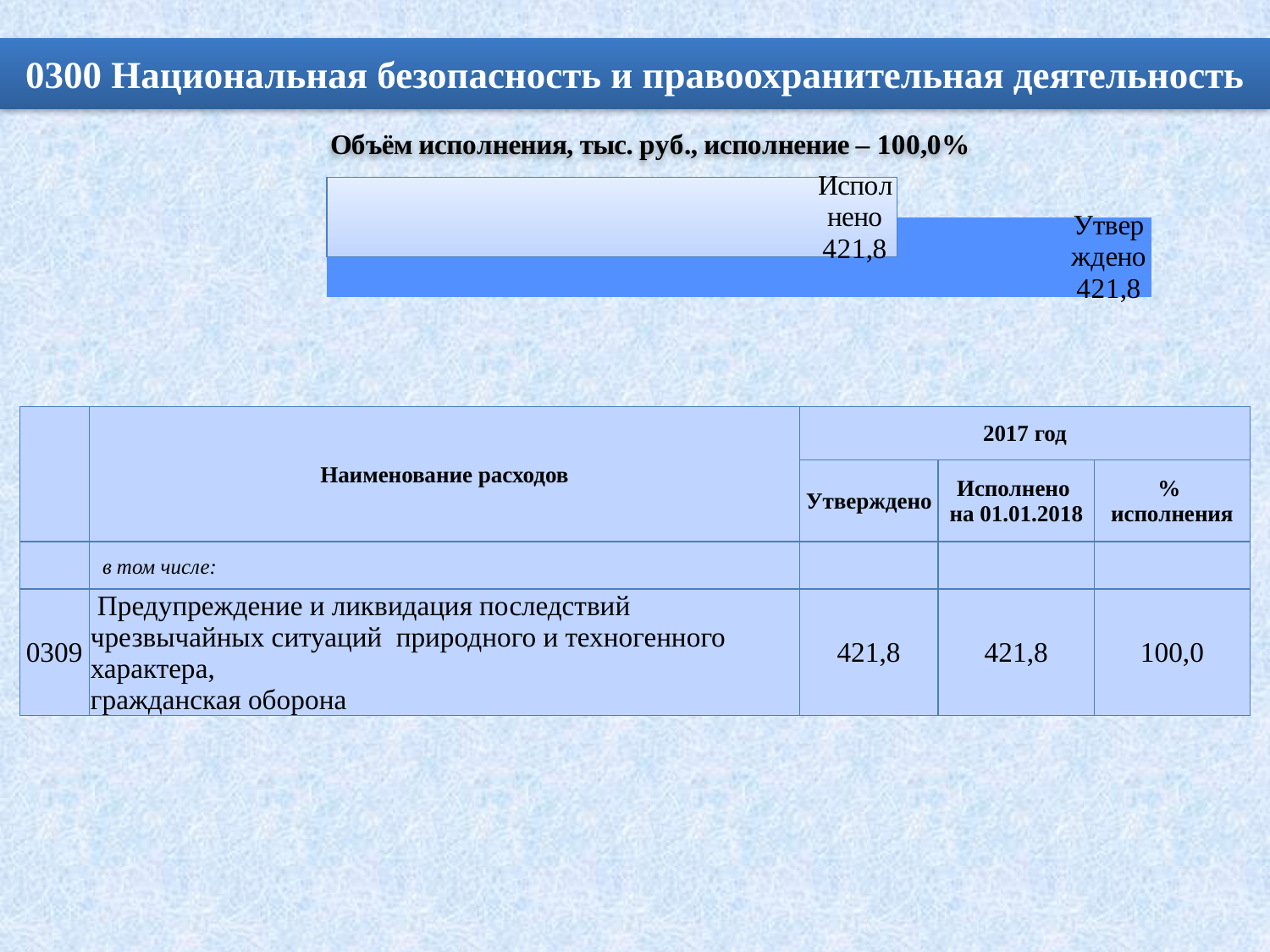
What kind of chart is shown on the slide? bar chart What is the title of the chart on the slide? Объём исполнения, тыс. руб., исполнение – 100,0% What is the value of the Утверждено bar in the chart? 421,8 What is the difference between the Утверждено value and the Исполнено value in the chart? 0,0 Is the value of the Утверждено bar equal to the value of the Исполнено bar? yes How many bars are plotted in the chart? 2 Are the bars in the chart oriented horizontally or vertically? horizontally What is the value of the Исполнено bar in the chart? 421,8